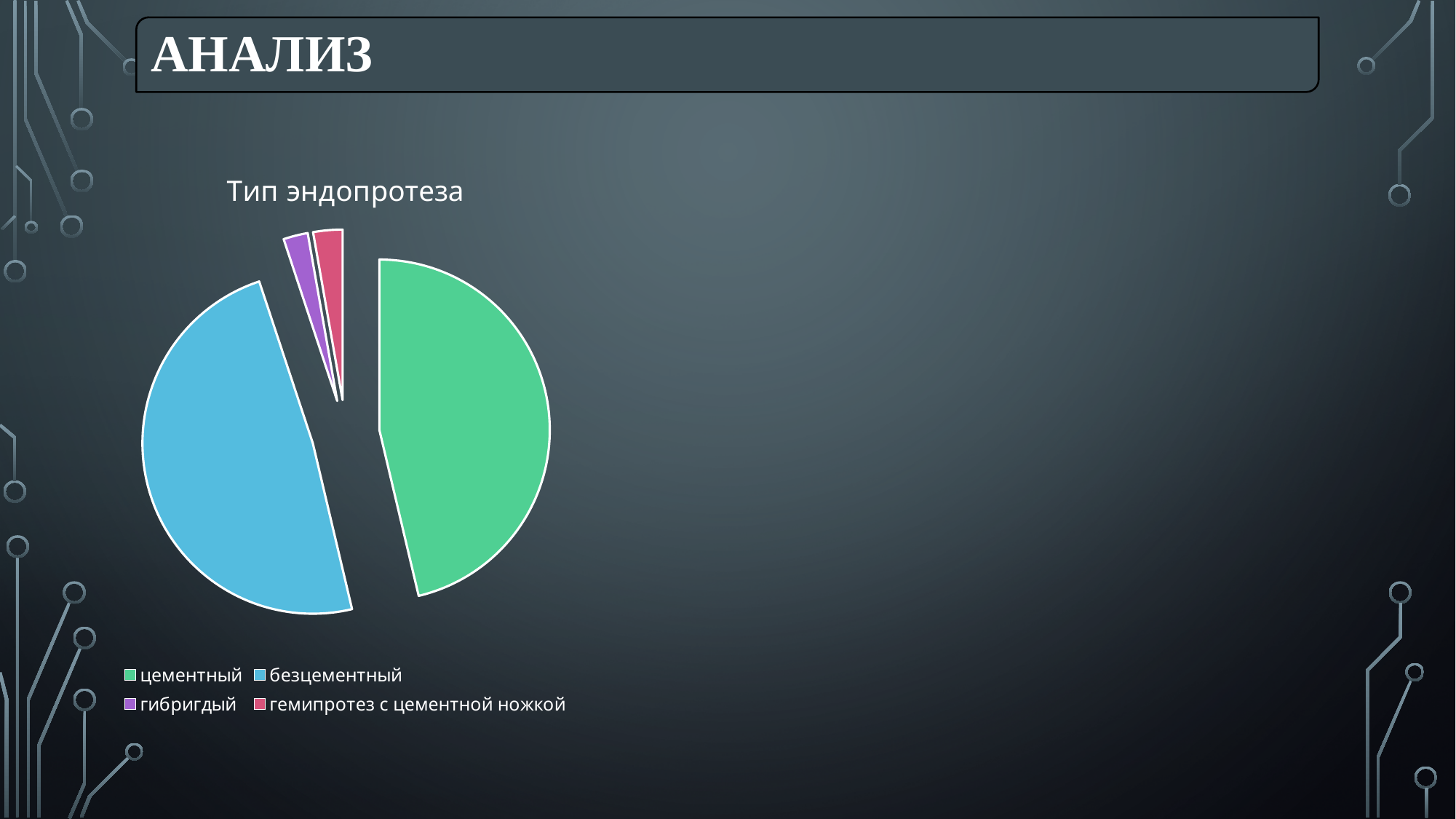
Which slice is larger, цементный or гемипротез с цементной ножкой? цементный Which slice is larger, цементный or безцементный? безцементный What is the title of the chart? Тип эндопротеза Which slice is larger, безцементный or гибригдый? безцементный How many entries does the legend list? 4 Which category has the largest slice of the pie? безцементный How many slices does the pie chart have? 4 Which colour represents безцементный in the legend? blue What kind of chart is shown on the slide? pie chart